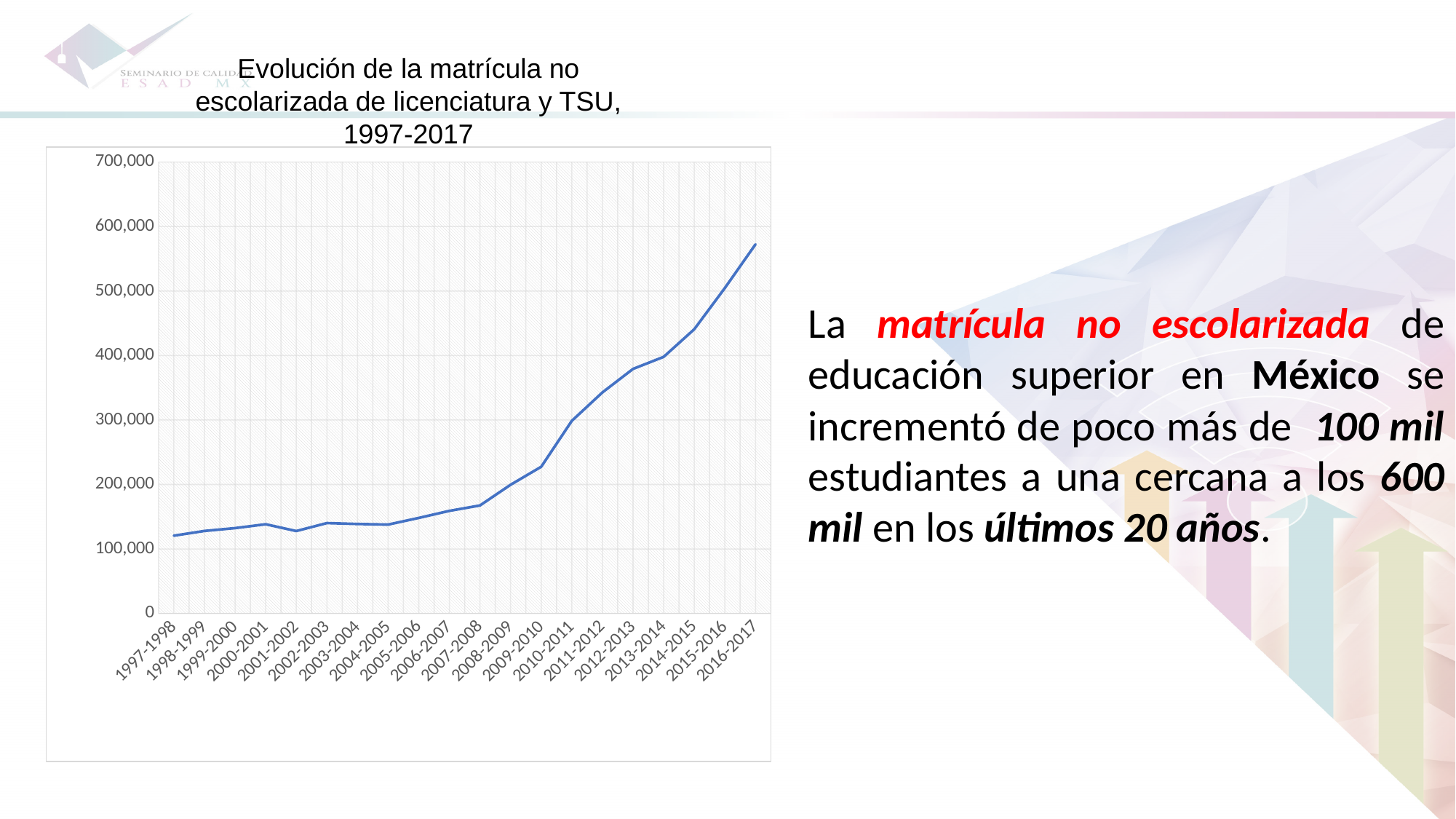
How many academic years are plotted along the x axis? 20 Which is larger, the value for 2009-2010 or the value for 2004-2005? 2009-2010 What kind of chart is shown on the slide? line chart Is the value for 2016-2017 greater or less than 500,000? greater What is the highest value shown on the y axis? 700,000 Is the value for 2014-2015 greater or less than 400,000? greater Is the value for 2009-2010 greater or less than 200,000? greater Which academic year has the highest value? 2016-2017 What is the title of the chart? Evolución de la matrícula no escolarizada de licenciatura y TSU, 1997-2017 Do the values generally rise or fall from 1997-1998 to 2016-2017? rise